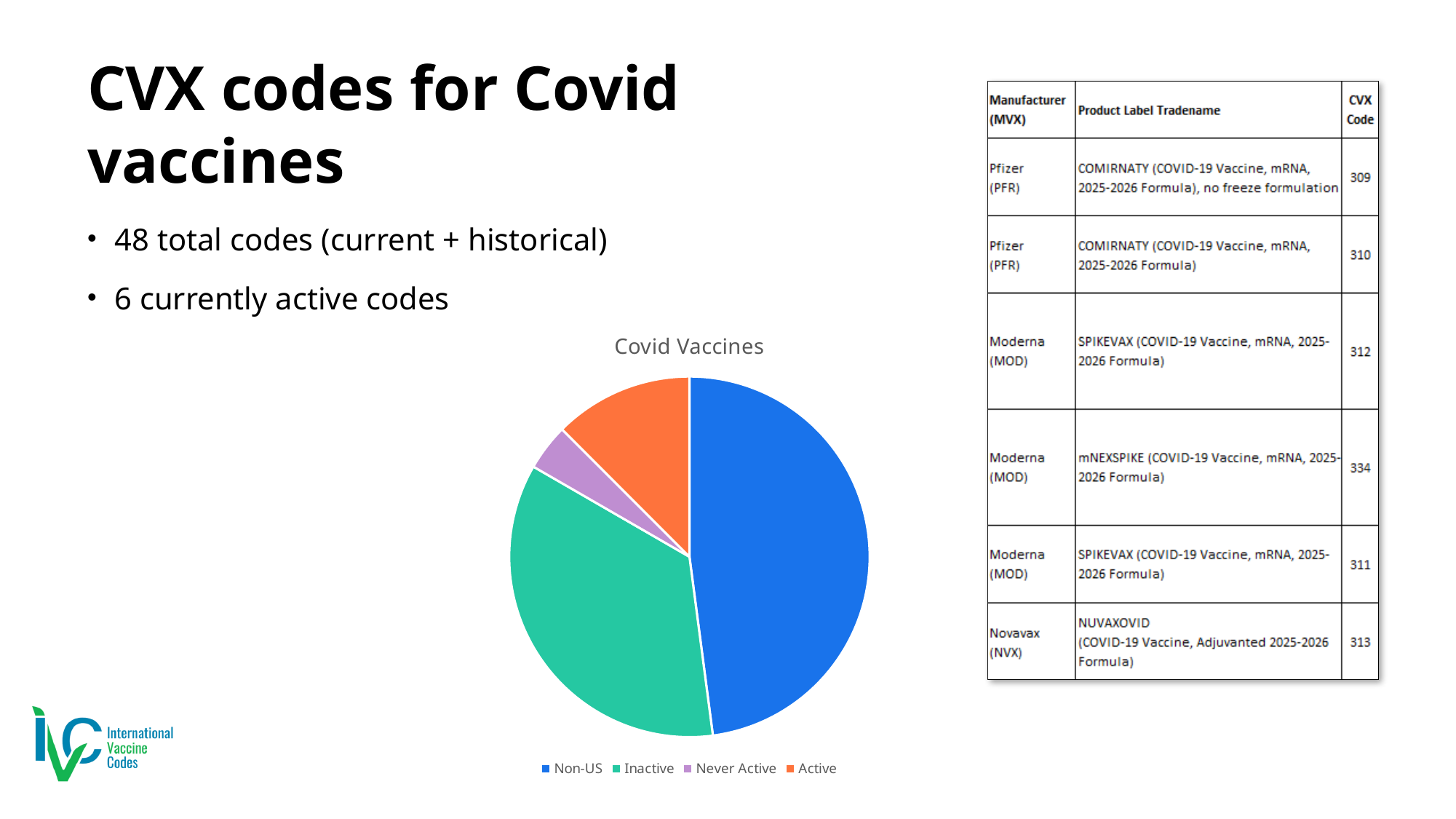
Which category has the largest slice of the pie? Non-US Which category has the smallest slice of the pie? Never Active What is the title of the chart? Covid Vaccines What colour is the Inactive slice in the pie chart? green Which slice is larger, Inactive or Active? Inactive Which slice is larger, Active or Never Active? Active How many entries does the chart legend list? 4 How many slices does the pie chart have? 4 Which slice is larger, Non-US or Inactive? Non-US What kind of chart is shown on the slide? pie chart